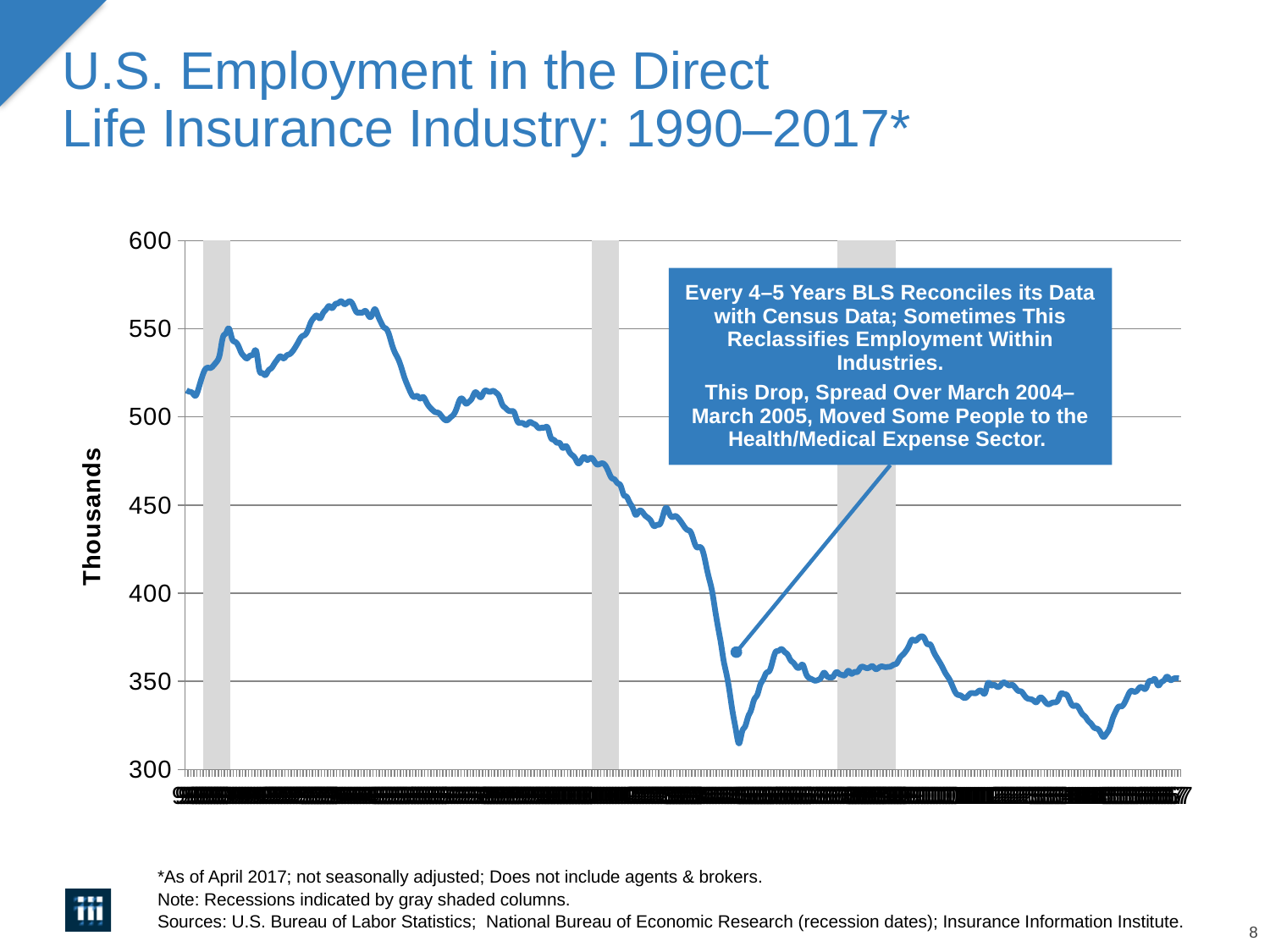
Is the value at the end of the series (April 2017) greater or less than 400? less What kind of chart is shown on the slide? Line chart Overall, do the values rise or fall from the start of the series in 1990 to the end in 2017? Fall Is the highest point of the line greater or less than 550? greater How many data series are plotted on the chart? 1 Is the value at the start of the series (1990) greater or less than 500? greater What is the lowest value shown on the vertical axis? 300 What is the label on the vertical axis? Thousands How many gray shaded recession columns are shown on the chart? 3 What is the highest value shown on the vertical axis? 600 Is the value at the end of the series (April 2017) greater or less than the value at the start (1990)? less